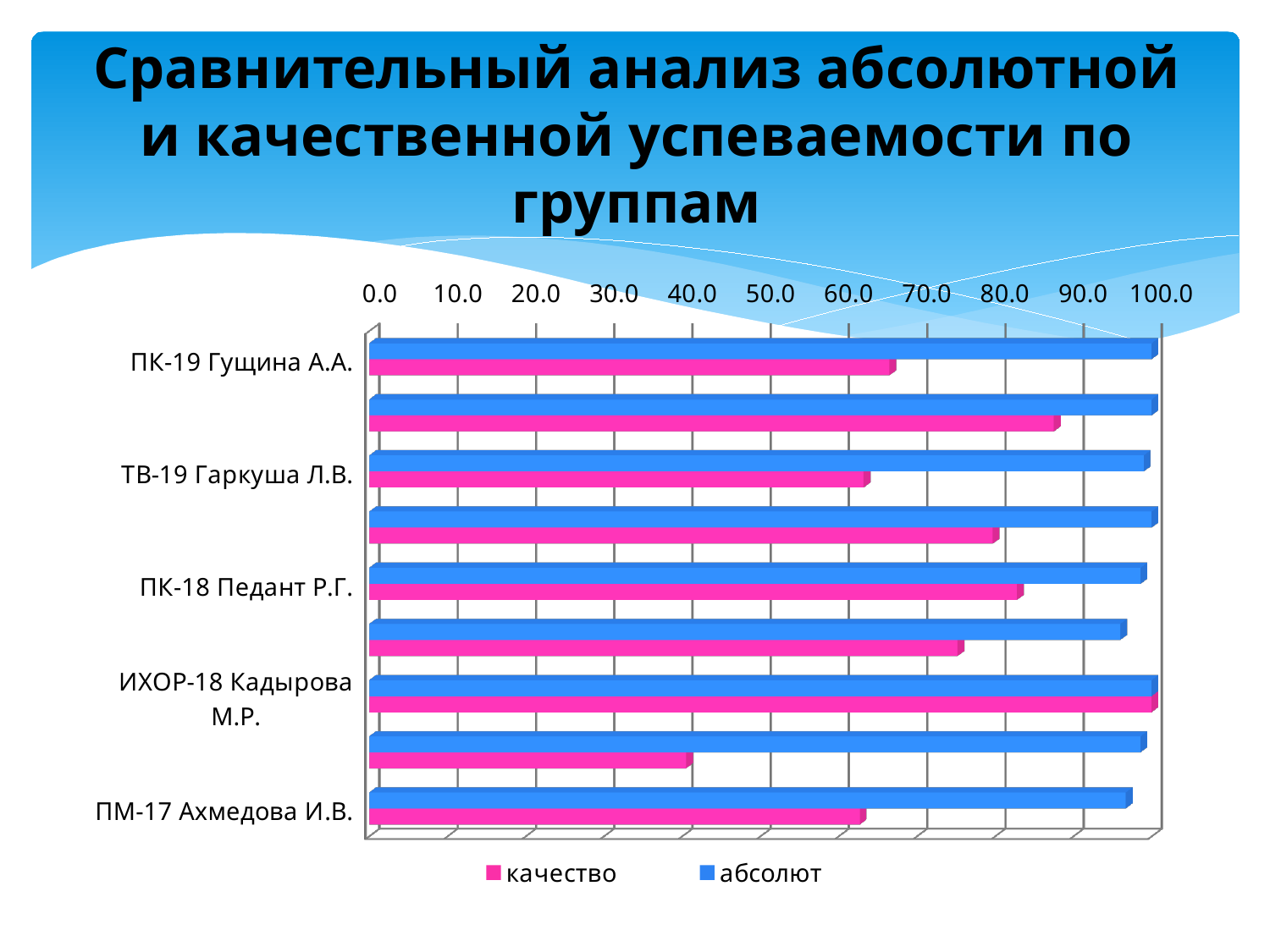
Among the labelled groups, which has the highest качество value? ИХОР-18 Кадырова М.Р. Is the качество value for ПК-19 Гущина А.А. greater or less than 70.0? less For ПК-19 Гущина А.А., which is larger: абсолют or качество? абсолют What kind of chart is shown on the slide? bar chart Which series is drawn in pink? качество Is the качество value for ПК-18 Педант Р.Г. greater or less than 70.0? greater Is the качество value for ПМ-17 Ахмедова И.В. greater or less than 70.0? less What are the two series named in the legend? качество and абсолют How many series does the legend list? 2